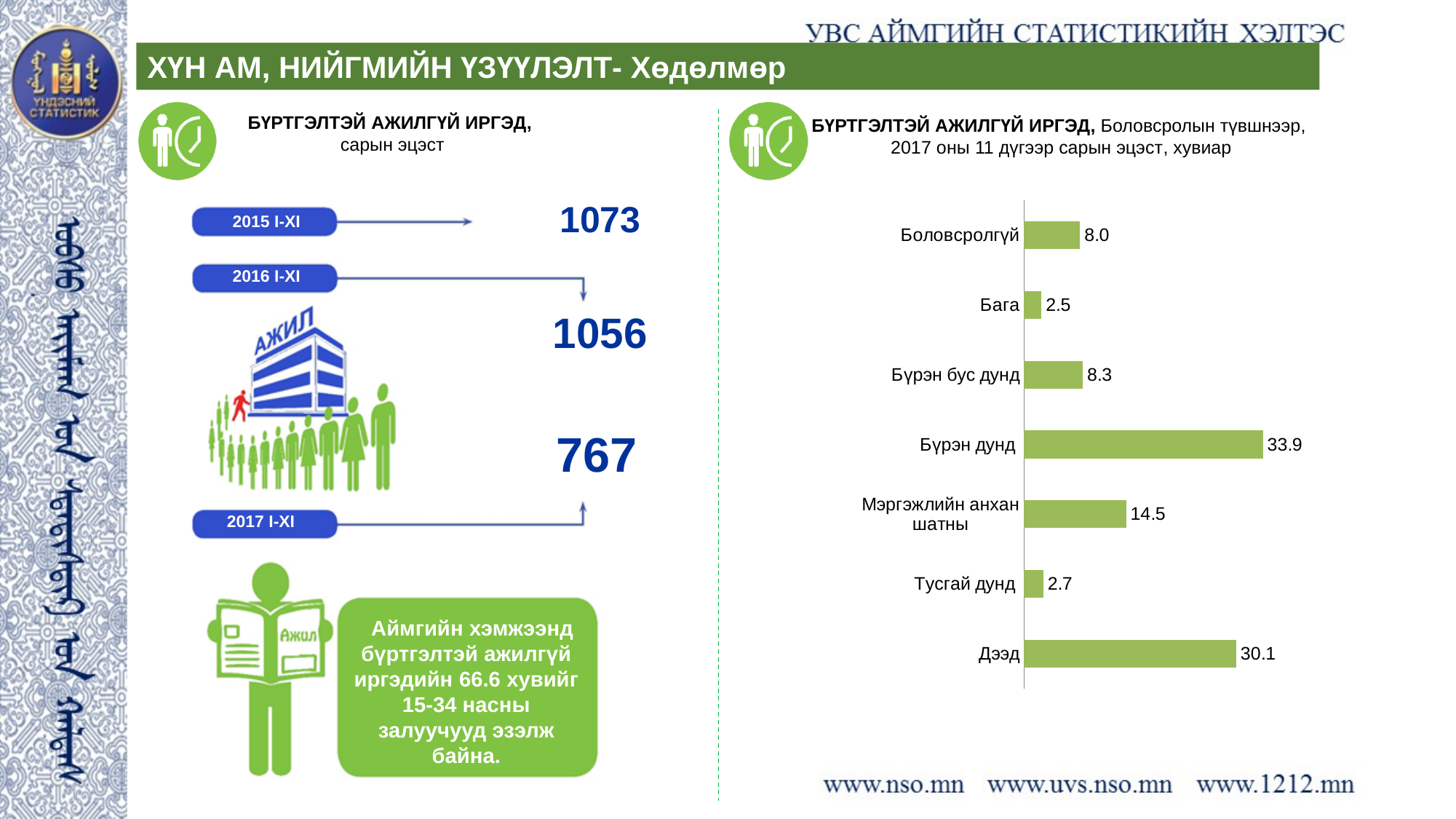
On the bar chart on the right, what is the value for Дээд? 30.1 On the bar chart on the right, what is the difference between the values for Бүрэн дунд and Дээд? 3.8 On the bar chart on the right, which category has the lowest value? Бага On the bar chart on the right, what is the value for Боловсролгүй? 8.0 On the bar chart on the right, which category has the highest value? Бүрэн дунд How many categories are shown on the bar chart on the right? 7 On the bar chart on the right, what is the value for Бүрэн дунд? 33.9 On the bar chart on the right, what is the value for Мэргэжлийн анхан шатны? 14.5 On the bar chart on the right, which is larger: the value for Бүрэн бус дунд or the value for Боловсролгүй? Бүрэн бус дунд In the infographic on the left, what is the value shown for 2017 I-XI? 767 What kind of chart is shown on the right side of the slide? Bar chart On the bar chart on the right, what is the difference between the values for Тусгай дунд and Бага? 0.2